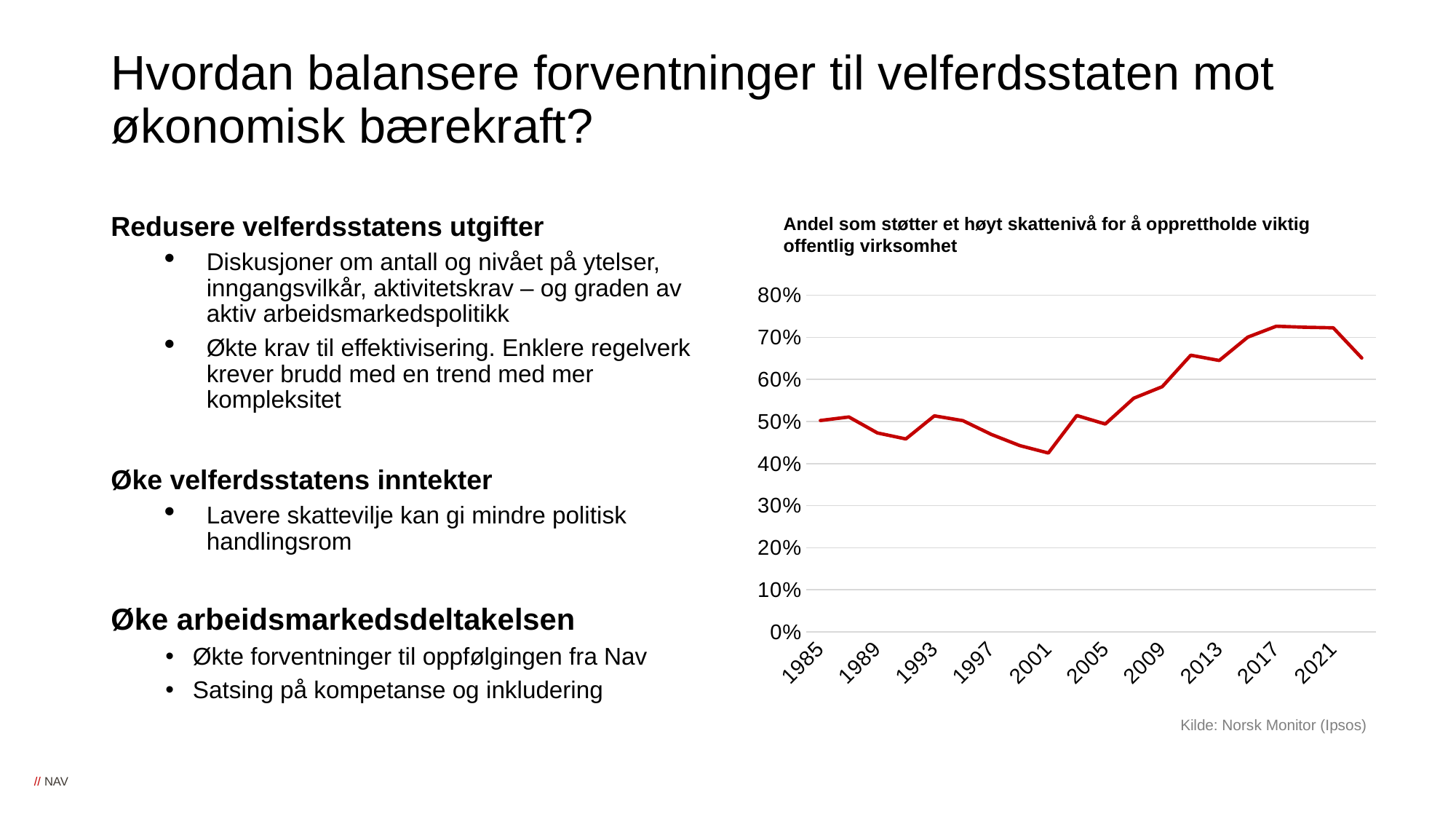
Is the value for 2017 greater or less than 60%? greater Which is larger, the value for 1985 or the value for 2017? 2017 What kind of chart is shown on the slide? line chart Is the value for 2001 greater or less than 50%? less Which labelled year has the lowest value on the chart? 2001 Which is larger, the value for 2001 or the value for 2009? 2009 Do the values generally rise or fall between 2001 and 2017? rise What source is cited below the chart? Norsk Monitor (Ipsos) Is the value for 2013 greater or less than 60%? greater What is the title of the chart? Andel som støtter et høyt skattenivå for å opprettholde viktig offentlig virksomhet How many year labels are shown on the x axis of the chart? 10